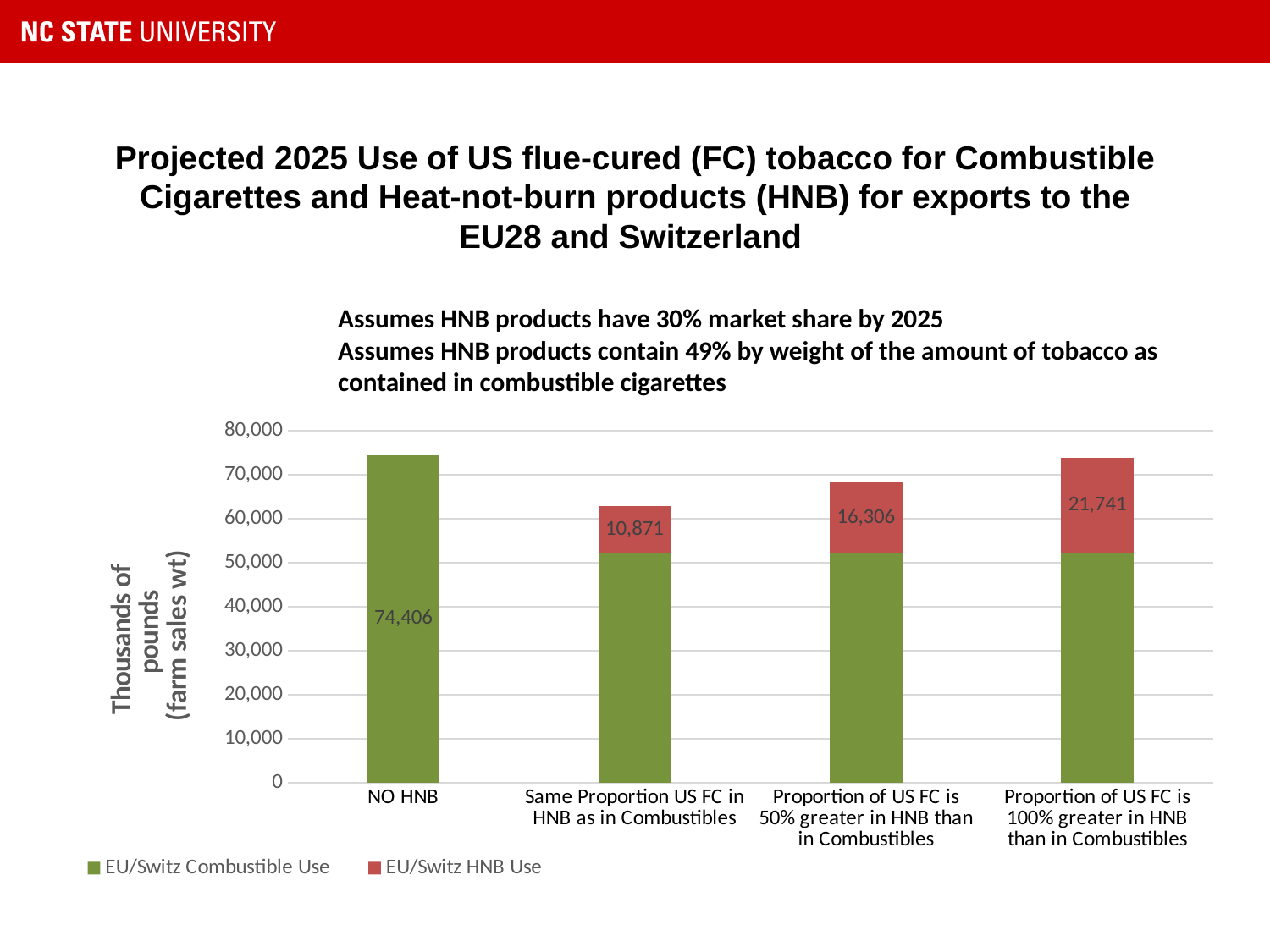
What is the EU/Switz HNB Use value for the 'Same Proportion US FC in HNB as in Combustibles' scenario? 10,871 What is the EU/Switz HNB Use value for the 'Proportion of US FC is 100% greater in HNB than in Combustibles' scenario? 21,741 What is the EU/Switz HNB Use value for the 'Proportion of US FC is 50% greater in HNB than in Combustibles' scenario? 16,306 What kind of chart is shown on the slide? Stacked bar chart Which scenario has the highest EU/Switz HNB Use? Proportion of US FC is 100% greater in HNB than in Combustibles What is the difference in EU/Switz HNB Use between the '100% greater' scenario and the 'Same Proportion' scenario? 10,870 Which is larger: EU/Switz HNB Use in the '50% greater' scenario or in the 'Same Proportion' scenario? 50% greater scenario How many scenarios (categories) are shown on the x axis? 4 Which scenario has the highest EU/Switz Combustible Use? NO HNB Is the EU/Switz Combustible Use value for the 'Same Proportion US FC in HNB as in Combustibles' scenario greater or less than 60,000? less What is the EU/Switz Combustible Use value for the 'NO HNB' scenario? 74,406 How many series does the legend list? 2